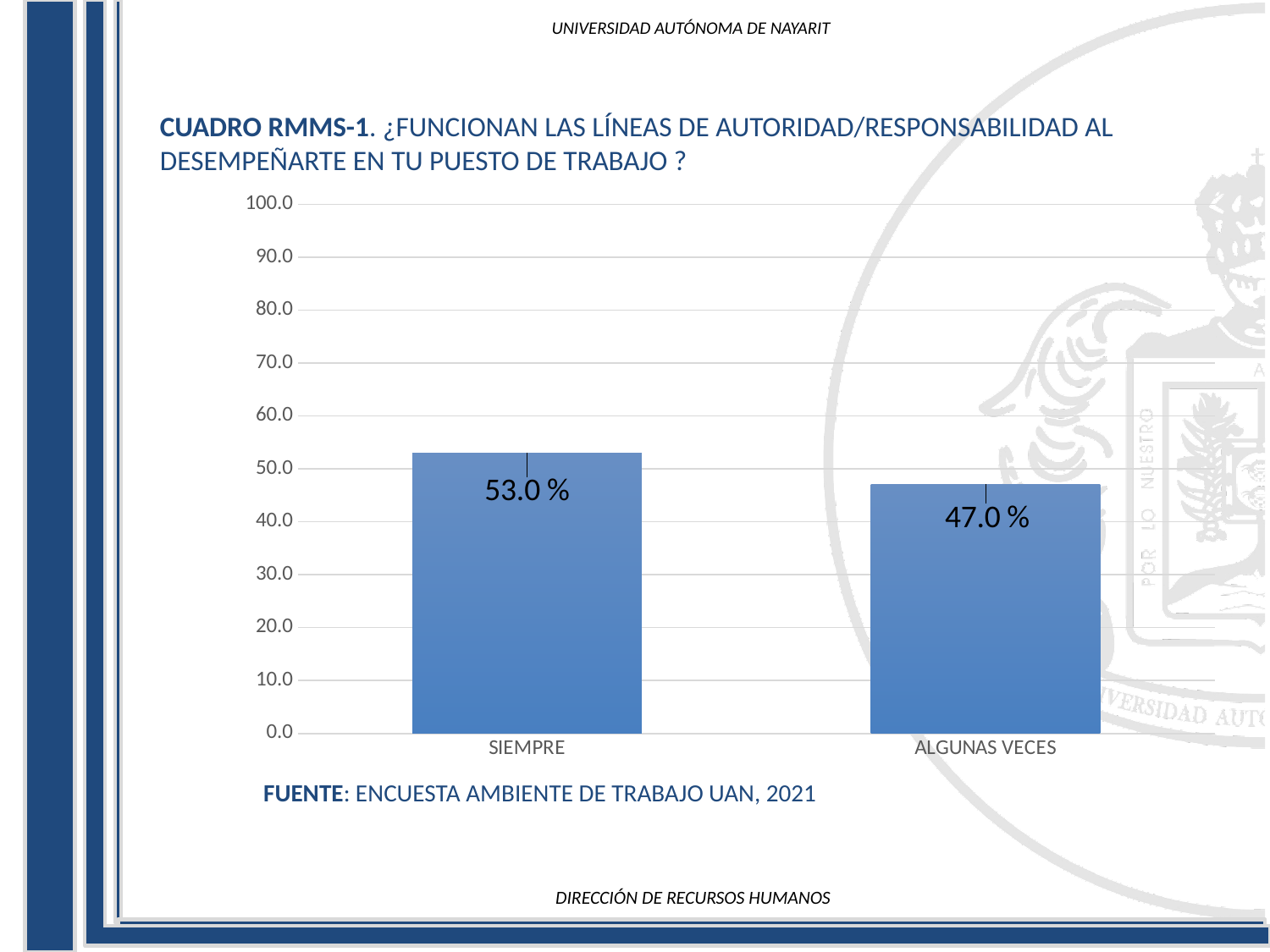
Is the value for SIEMPRE greater or less than 50.0? greater What is the maximum value shown on the y axis? 100.0 What is the difference between the values for SIEMPRE and ALGUNAS VECES? 6.0 % Is the value for ALGUNAS VECES greater or less than 50.0? less What is the total of the two bar values? 100.0 % What is the value for ALGUNAS VECES? 47.0 % What is the value for SIEMPRE? 53.0 % Which is larger, the value for SIEMPRE or the value for ALGUNAS VECES? SIEMPRE How many categories are shown on the x axis? 2 Which category has the lowest value? ALGUNAS VECES What kind of chart is shown on the slide? bar chart Which category has the highest value? SIEMPRE